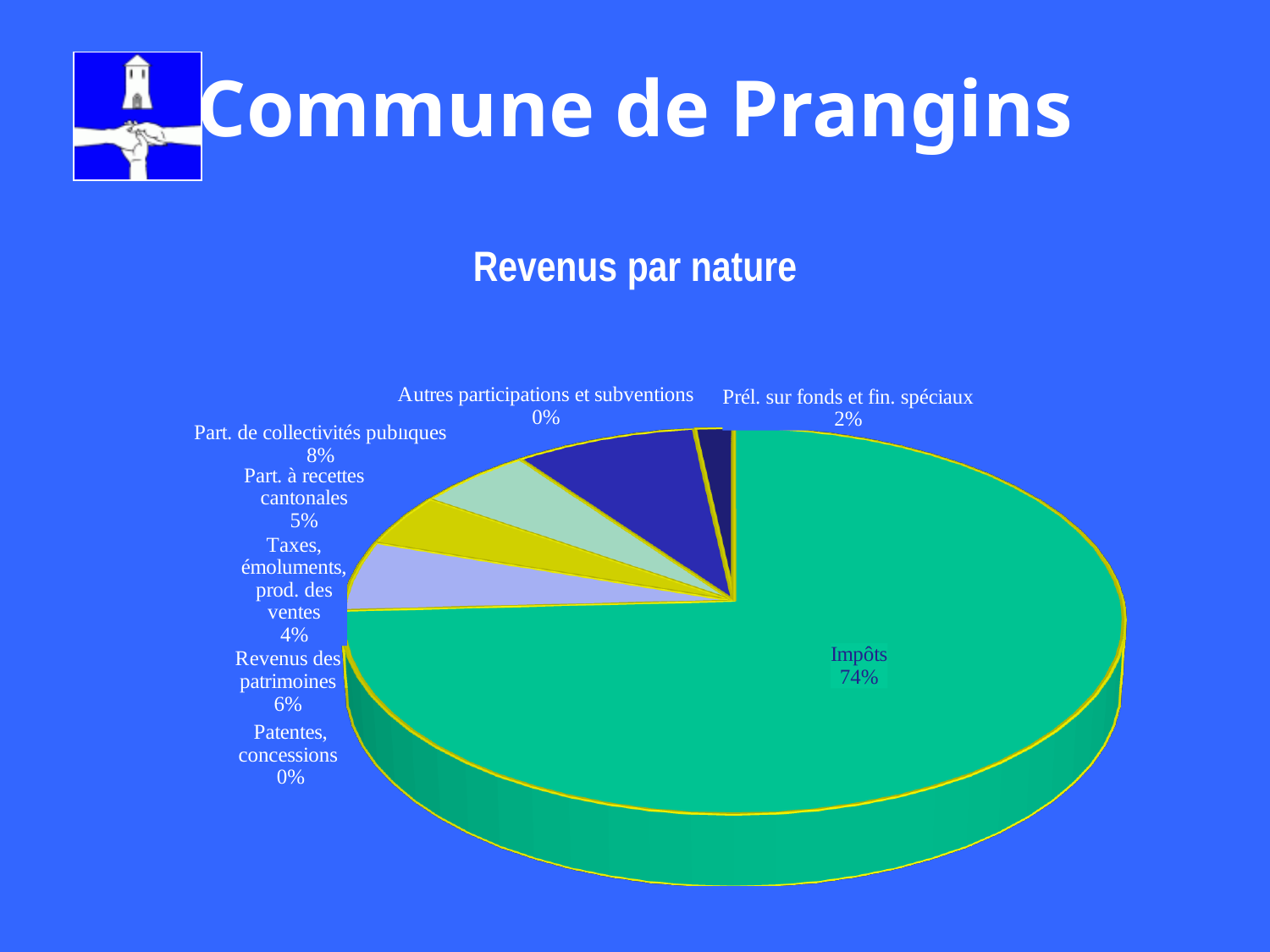
What percentage is shown for Part. de collectivités publiques? 8% Which is larger, Revenus des patrimoines or Part. à recettes cantonales? Revenus des patrimoines What is the title of the chart? Revenus par nature What percentage is shown for Taxes, émoluments, prod. des ventes? 4% How many categories are shown in the pie chart? 8 What percentage is shown for Part. à recettes cantonales? 5% What percentage is shown for Prél. sur fonds et fin. spéciaux? 2% What is the difference in percentage points between Impôts and Part. de collectivités publiques? 66 Which category has the largest share of the pie? Impôts What share of the pie does Impôts represent? 74% What percentage is shown for Revenus des patrimoines? 6% What type of chart is shown on the slide? Pie chart